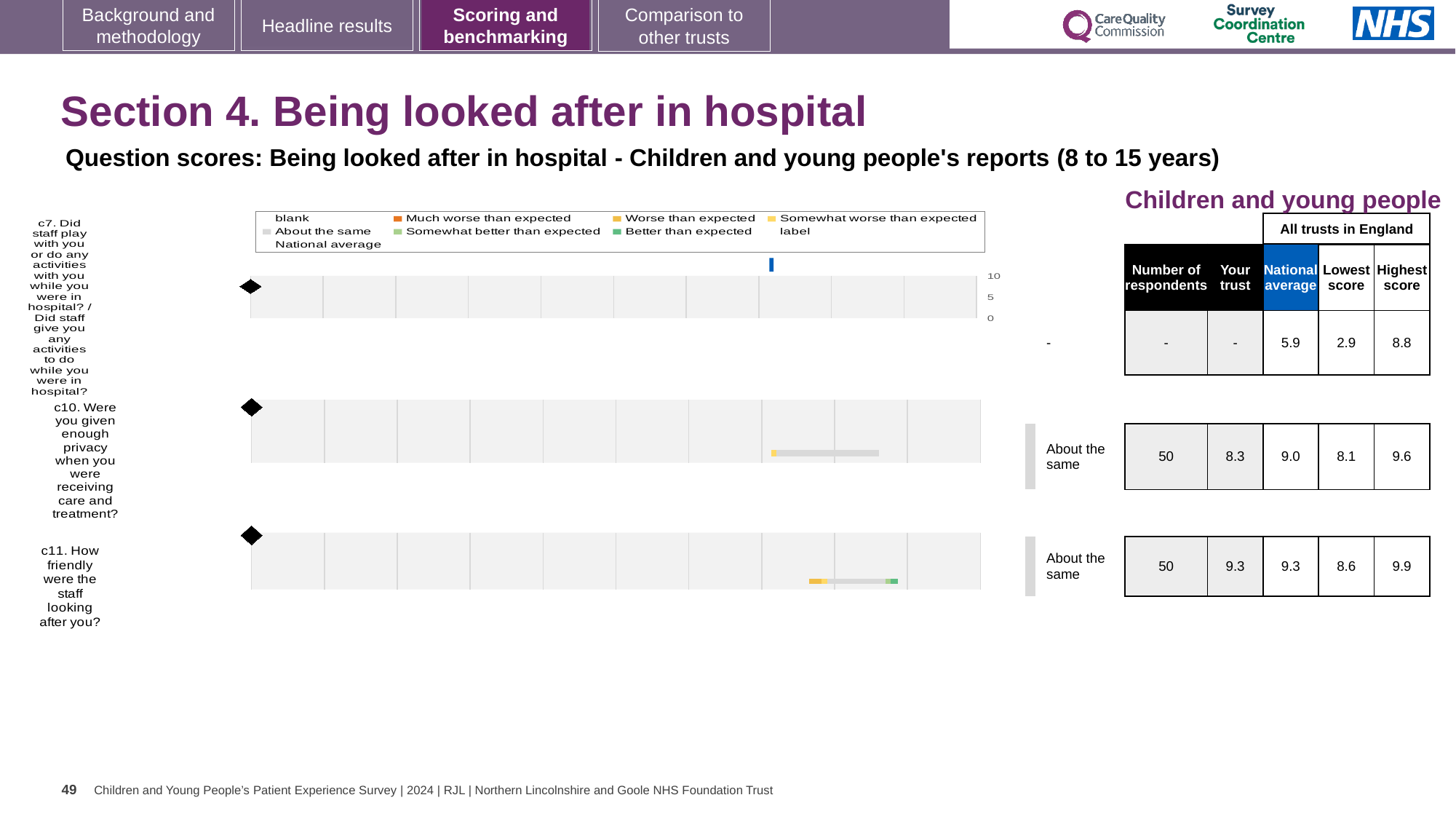
Which question has the lowest 'Lowest score' value? c7 What colour does the legend use for 'Better than expected'? Green How many respondents are listed for c11 (How friendly were the staff looking after you?)? 50 How many survey questions (categories) are plotted on the chart? 3 What is the highest score across all trusts in England for c7 (Did staff play with you or do any activities with you while you were in hospital?)? 8.8 Which question has the higher 'Your trust' score, c10 or c11? c11 What is the difference between the national average and the 'Your trust' score for c10 (Were you given enough privacy)? 0.7 What is the national average score for c11 (How friendly were the staff looking after you?)? 9.3 Which question has the highest national average score? c11 What kind of chart is shown on the slide? Bar chart What is the difference between the highest score and the lowest score for c10 (Were you given enough privacy)? 1.5 What is the 'Your trust' score for c10 (Were you given enough privacy when you were receiving care and treatment?)? 8.3